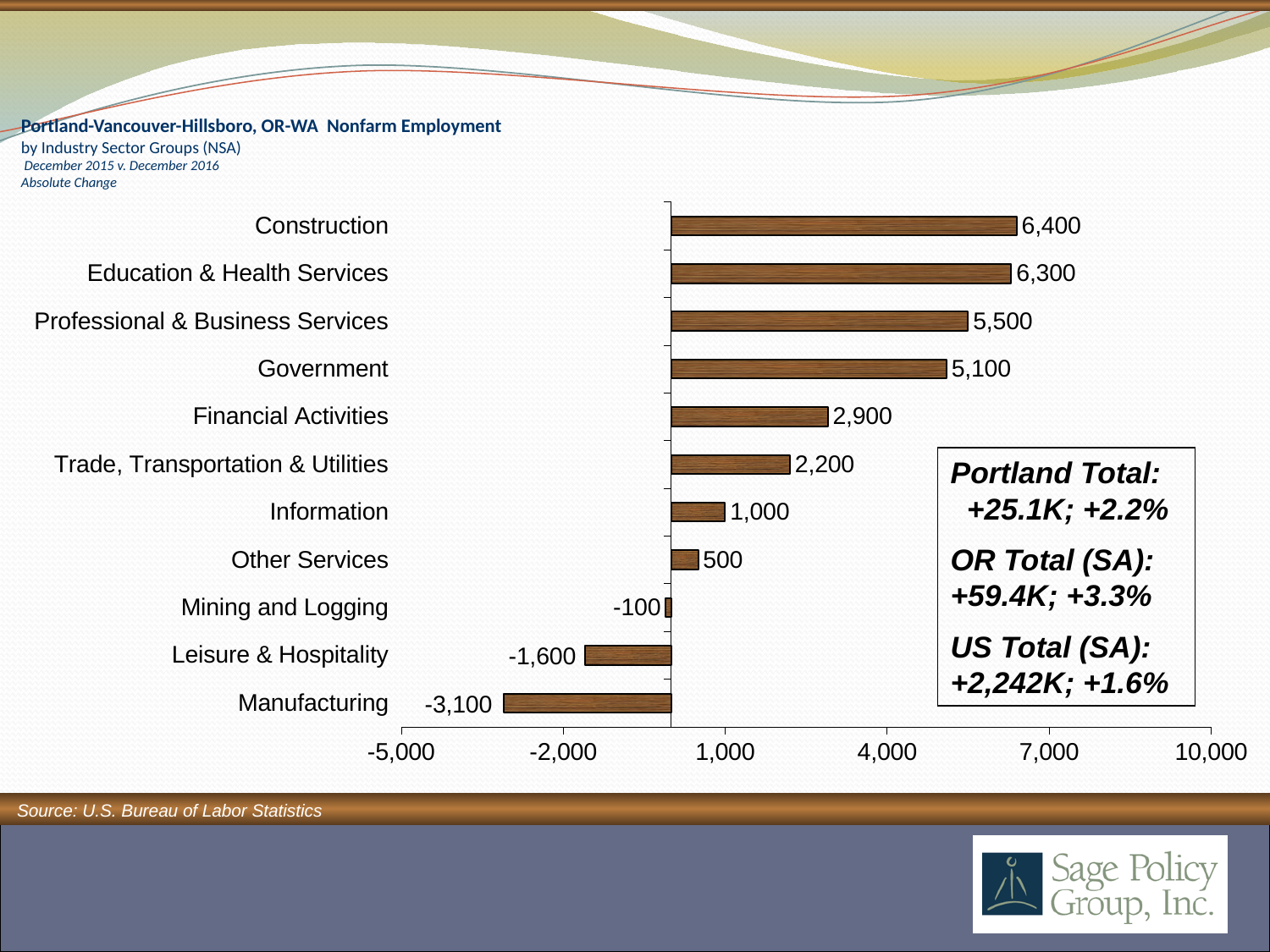
How many industry sectors show a negative change? 3 How many industry sector groups are shown in the chart? 11 What is the value shown for Manufacturing? -3,100 What is the value shown for Leisure & Hospitality? -1,600 Which is larger, the value for Trade, Transportation & Utilities or the value for Information? Trade, Transportation & Utilities What is the difference between the values for Construction and Government? 1,300 What kind of chart is shown on the slide? Bar chart What is the source cited for the chart data? U.S. Bureau of Labor Statistics What is the absolute change in nonfarm employment for Construction? 6,400 Which industry sector has the lowest absolute change? Manufacturing Which industry sector has the highest absolute change? Construction What is the value shown for Financial Activities? 2,900